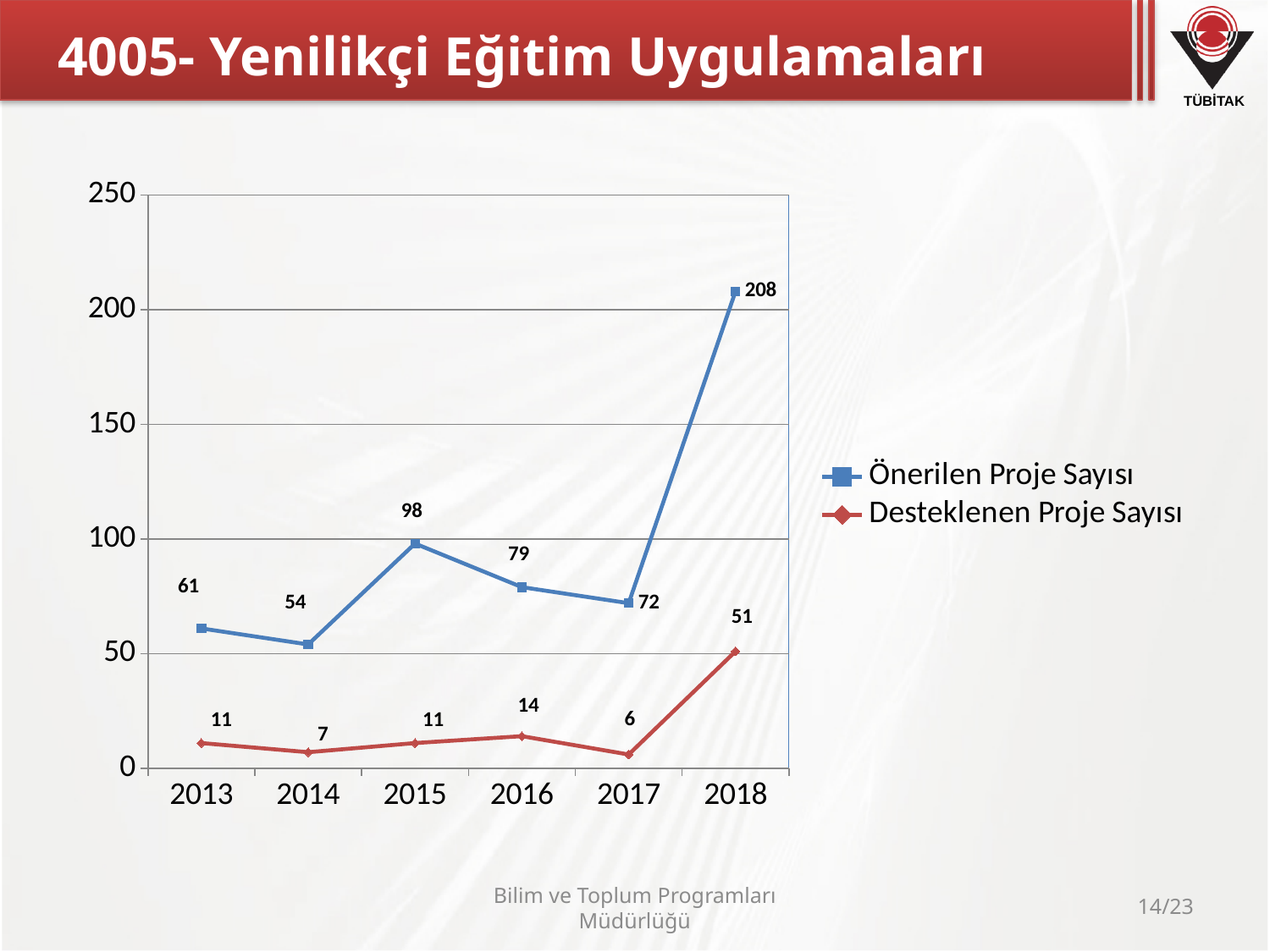
What kind of chart is shown on the slide? line chart Which is larger: Önerilen Proje Sayısı in 2014 or in 2017? 2017 What colour is the line for Desteklenen Proje Sayısı? red What is the difference between Önerilen Proje Sayısı and Desteklenen Proje Sayısı in 2018? 157 What is the value of Desteklenen Proje Sayısı in 2016? 14 Does Önerilen Proje Sayısı rise or fall from 2017 to 2018? rise In which year is Desteklenen Proje Sayısı lowest? 2017 How many years are shown on the x axis? 6 In which year is Önerilen Proje Sayısı highest? 2018 Is the value of Önerilen Proje Sayısı in 2018 greater or less than 200? greater How many series does the legend list? 2 What is the value of Önerilen Proje Sayısı in 2015? 98